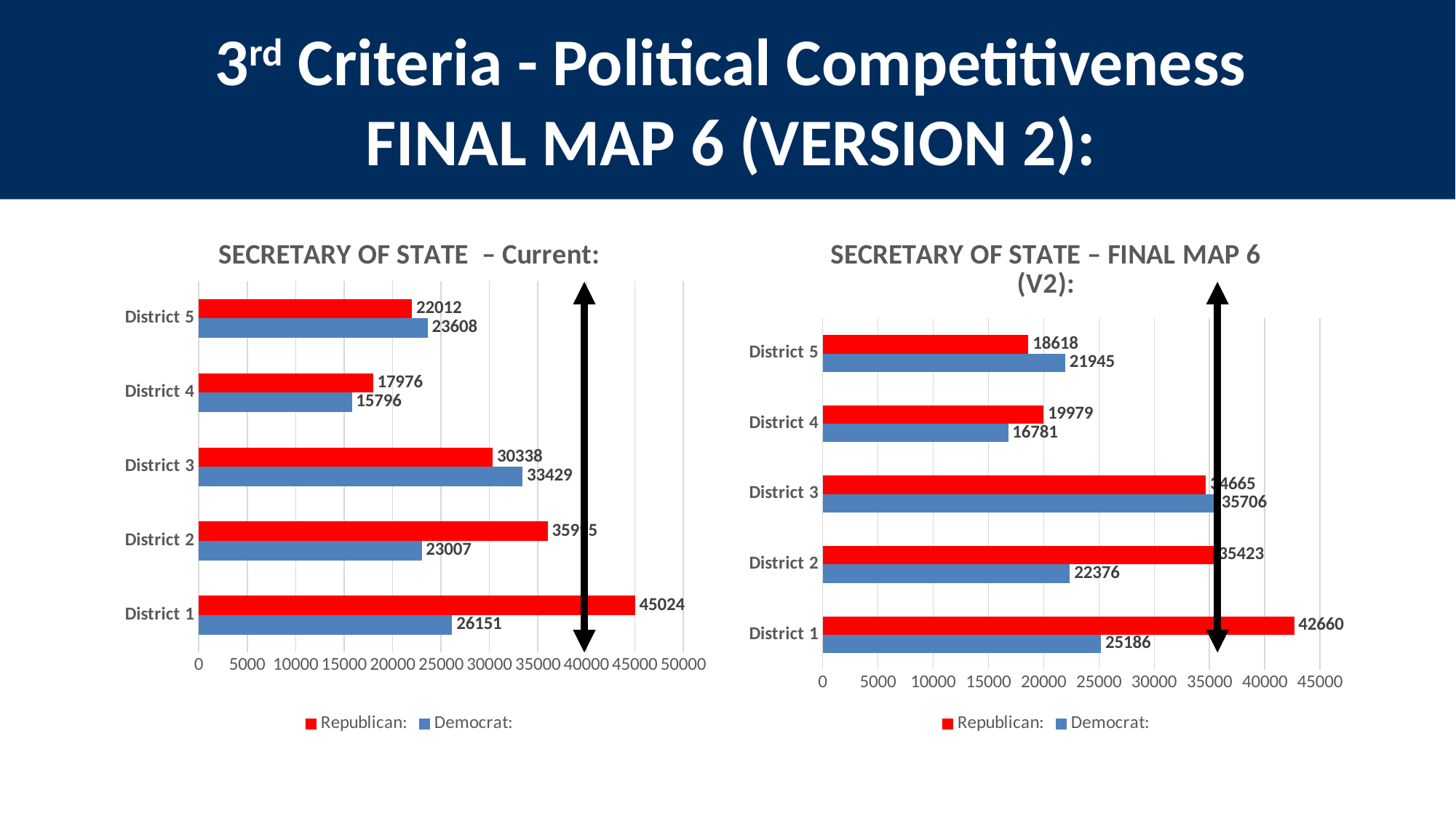
In the 'SECRETARY OF STATE – FINAL MAP 6 (V2)' chart, is the Republican value for District 1 greater or less than 40000? greater In the 'SECRETARY OF STATE – Current' chart, what is the Republican value for District 1? 45024 How many districts are shown in the 'SECRETARY OF STATE – Current' chart? 5 In the 'SECRETARY OF STATE – FINAL MAP 6 (V2)' chart, what is the Republican value for District 2? 35423 How many series does the legend of the 'SECRETARY OF STATE – FINAL MAP 6 (V2)' chart list? 2 In the 'SECRETARY OF STATE – Current' chart, which district has the highest Republican value? District 1 In the 'SECRETARY OF STATE – Current' chart, what is the Democrat value for District 3? 33429 In the 'SECRETARY OF STATE – FINAL MAP 6 (V2)' chart, what is the difference between the Republican and Democrat values for District 1? 17474 In the 'SECRETARY OF STATE – FINAL MAP 6 (V2)' chart, which district has the lowest Democrat value? District 4 What type of chart is the 'SECRETARY OF STATE – Current' chart? Bar chart In the 'SECRETARY OF STATE – Current' chart, which is larger for District 4, the Republican value or the Democrat value? Republican In the 'SECRETARY OF STATE – FINAL MAP 6 (V2)' chart, what is the Democrat value for District 5? 21945